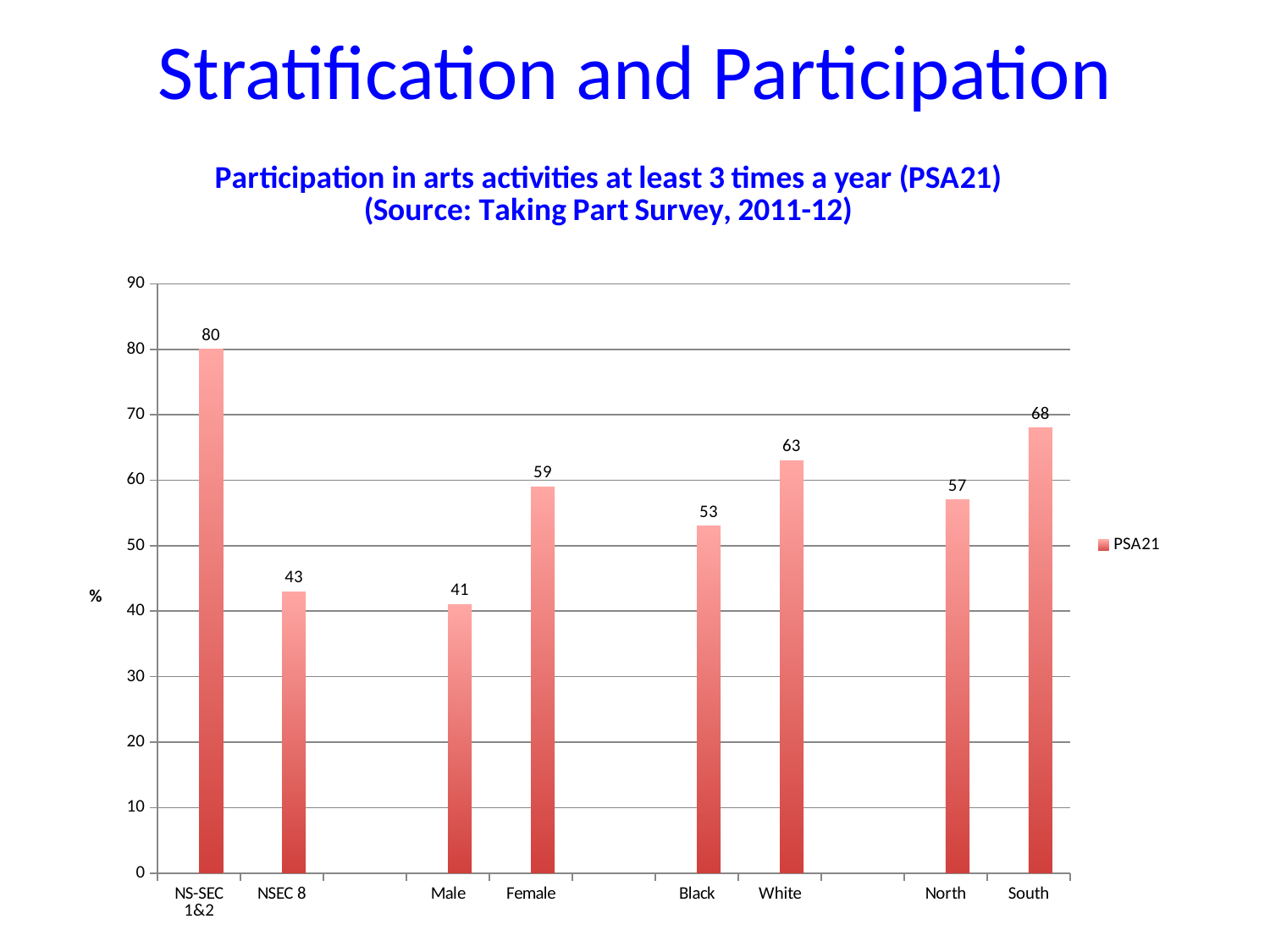
How many categories are shown on the x axis? 8 What is the value for Black? 53 How many series does the legend list? 1 Which category has the lowest value? Male What is the difference between the values for South and North? 11 What is the difference between the values for NS-SEC 1&2 and NSEC 8? 37 What is the name of the series in the legend? PSA21 What is the value for NS-SEC 1&2? 80 What is the value for Female? 59 What kind of chart is shown? Bar chart Which is larger, the value for White or the value for Black? White Which category has the highest value? NS-SEC 1&2